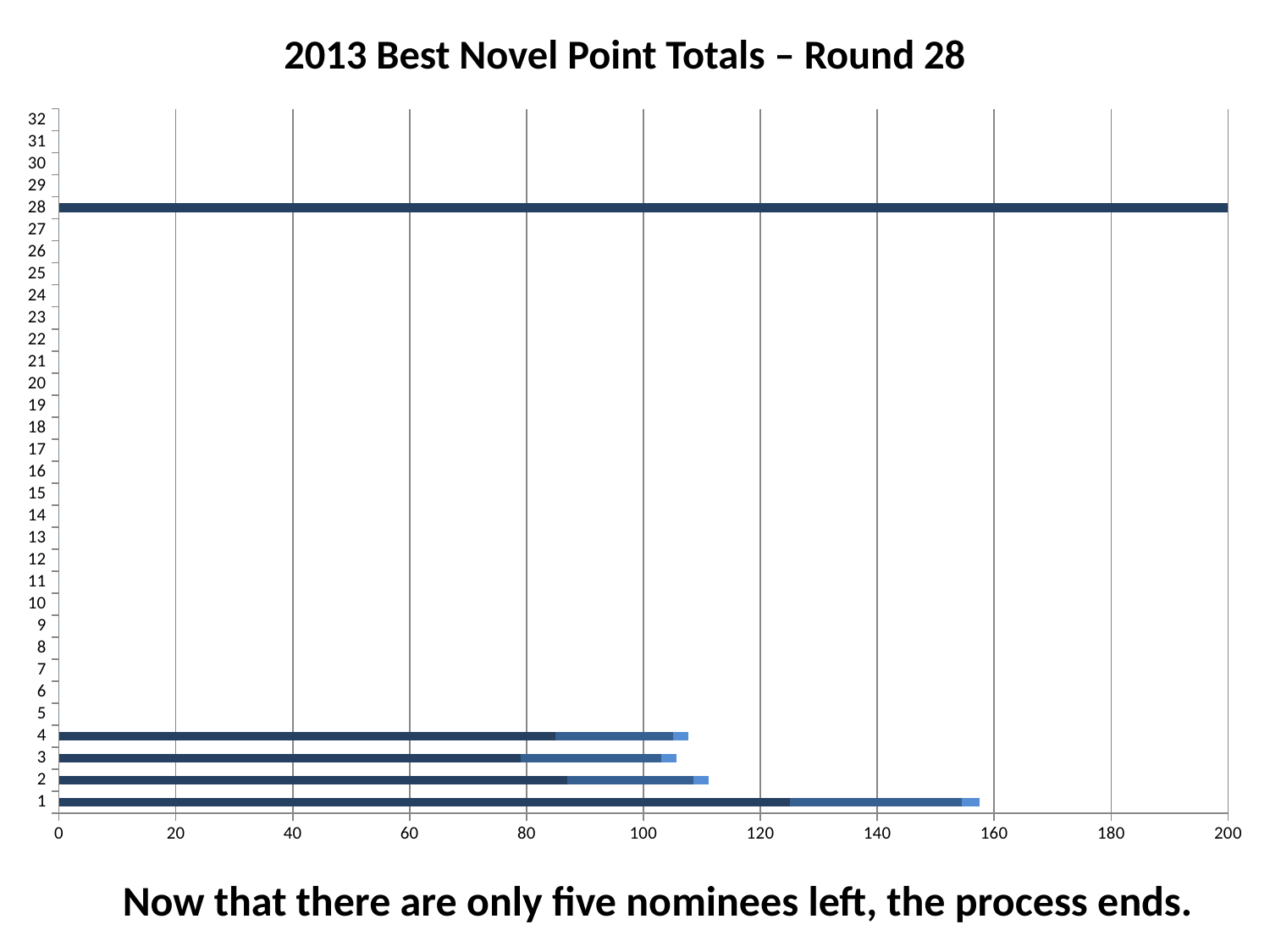
What kind of chart is shown on the slide? bar chart How many categories have a visible bar in the chart? 5 What is the title of the chart? 2013 Best Novel Point Totals – Round 28 Is the value for category 1 greater or less than 140? greater Is the value for category 4 greater or less than 120? less Which has the larger value, category 1 or category 4? 1 Is the value for category 1 greater or less than 160? less Which category has the longest bar in the chart? 28 What is the highest value shown on the horizontal axis? 200 How many categories are labelled on the vertical axis of the chart? 32